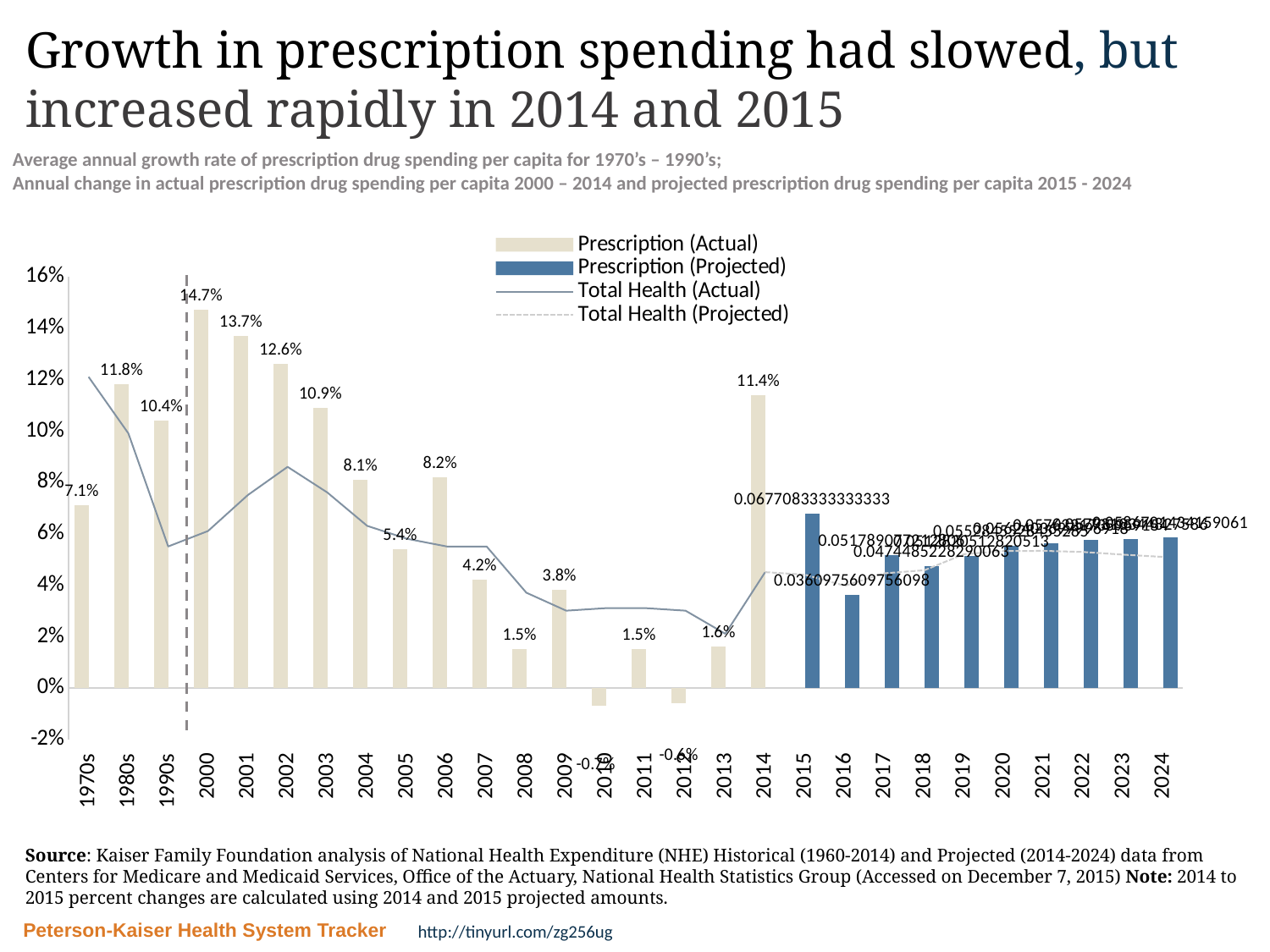
What is the difference between the Prescription (Actual) values for 2000 and 2001? 1.0 percentage point What is the value for the 1980s for Prescription (Actual)? 11.8% Is the Prescription (Projected) value for 2016 greater or less than 4%? less What is the value for 2014 for Prescription (Actual)? 11.4% Do the Prescription (Actual) values rise or fall from 2000 to 2005? fall Which is larger, the Prescription (Actual) value for 2005 or for 2006? 2006 What kind of chart is shown? combination bar and line chart What is the value for 2009 for Prescription (Actual)? 3.8% How many series does the legend list? 4 What is the value for 2000 for Prescription (Actual)? 14.7% Which category has the highest Prescription (Actual) value? 2000 What is the difference between the Prescription (Actual) values for 2014 and 2013? 9.8 percentage points